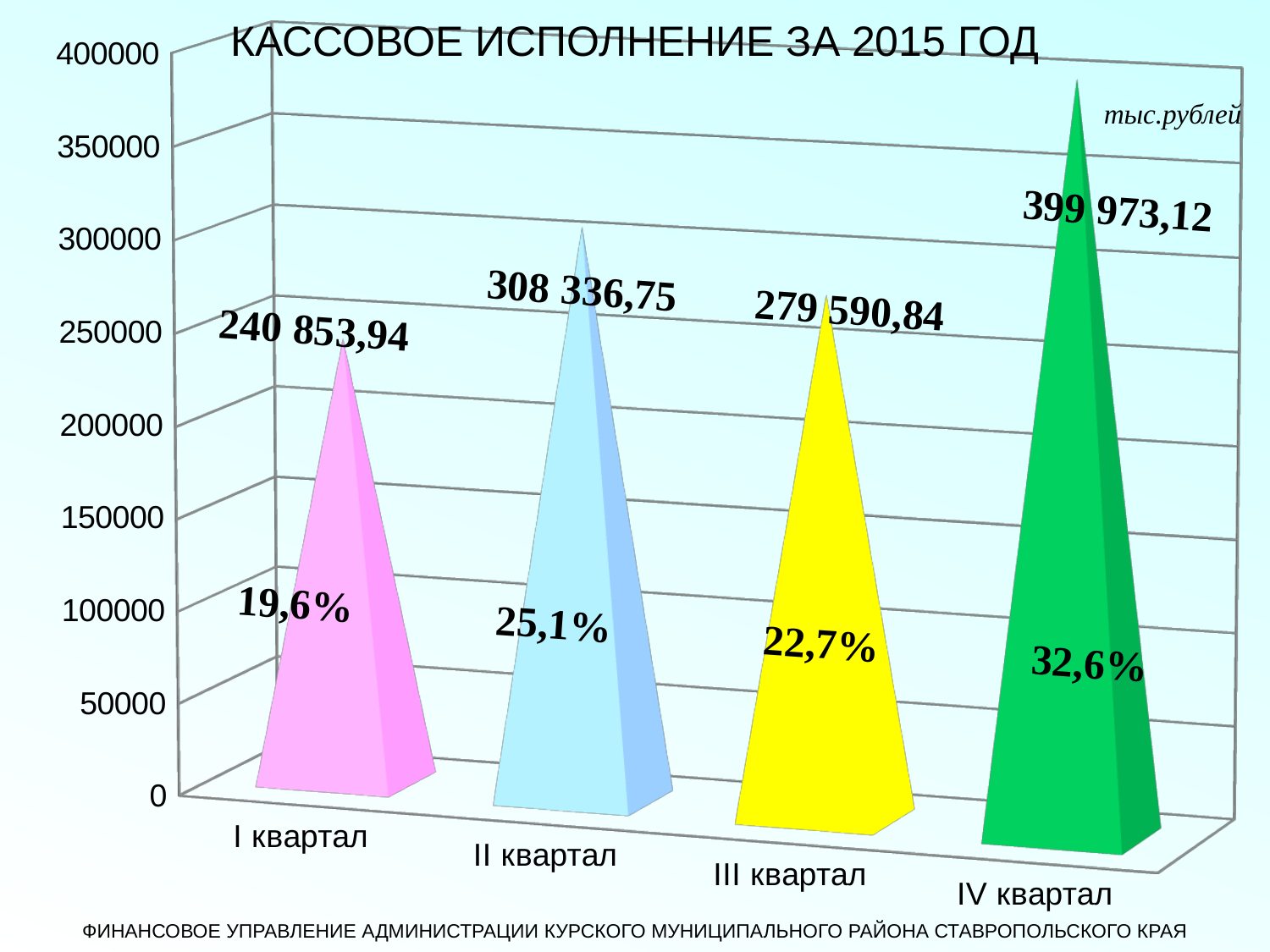
What kind of chart is shown on the slide? Bar chart What is the difference between the values for IV квартал and I квартал? 159 119,18 What percentage is shown on the bar for IV квартал? 32,6% What is the title of the chart? КАССОВОЕ ИСПОЛНЕНИЕ ЗА 2015 ГОД How many quarters (categories) are shown on the chart? 4 What is the value for III квартал? 279 590,84 What is the value for II квартал? 308 336,75 Which quarter has the lowest value? I квартал Which quarter has the highest value? IV квартал Which is larger, the value for II квартал or III квартал? II квартал What is the value for I квартал? 240 853,94 What is the value for IV квартал? 399 973,12